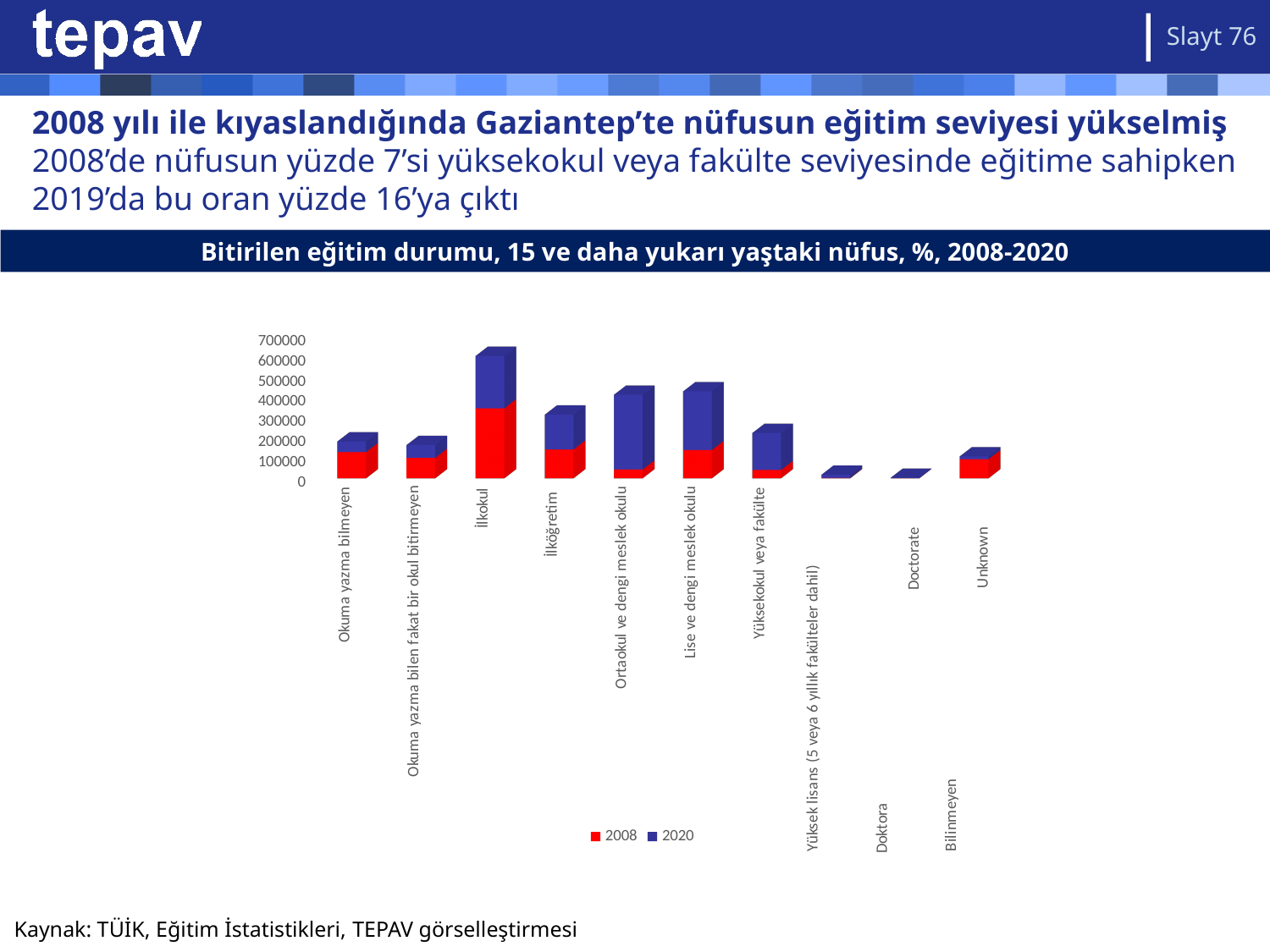
Which category has the smallest stacked bar? Doktora Is the total stacked value for İlkokul greater or less than 500000? greater Is the total stacked value for Yüksekokul veya fakülte greater or less than 300000? less What kind of chart is shown on the slide? bar chart Is the total stacked value for Doktora greater or less than 100000? less Which colour represents the 2008 series? red Which 2008 segment is larger, İlkokul or Lise ve dengi meslek okulu? İlkokul Which category has the tallest stacked bar? İlkokul Which stacked bar is taller, İlkokul or İlköğretim? İlkokul Which years are listed in the legend? 2008 and 2020 How many series does the legend list? 2